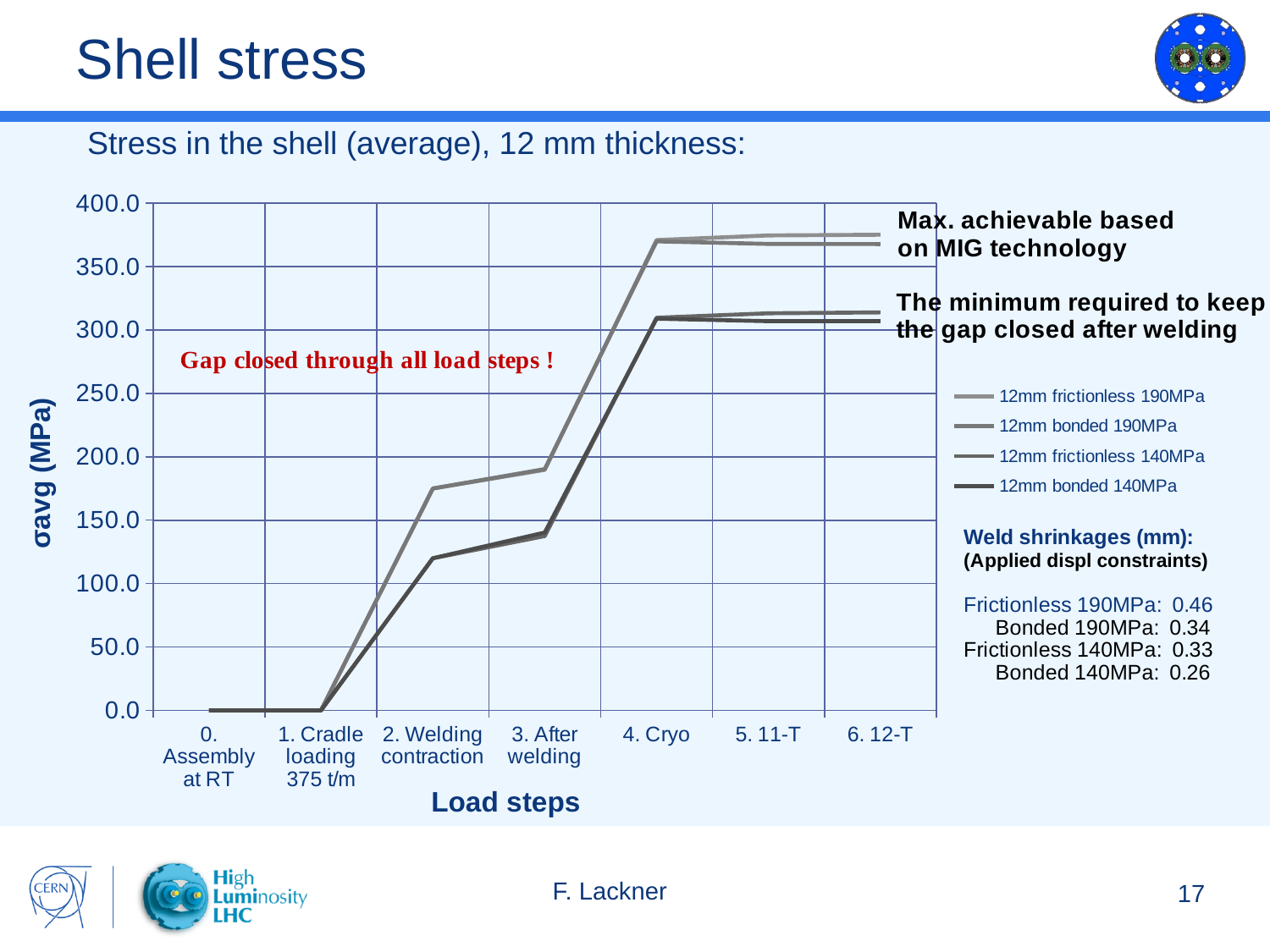
Is the value of the 12mm bonded 140MPa series at 4. Cryo greater or less than 350? less Is the value of the 12mm bonded 140MPa series at 2. Welding contraction greater or less than 150? less Do the values of the 12mm bonded 190MPa series rise or fall from 1. Cradle loading 375 t/m to 4. Cryo? rise How many load steps are shown on the x axis of the chart? 7 Is the value of the 12mm frictionless 190MPa series at 4. Cryo greater or less than 350? greater What is the value of the 12mm bonded 140MPa series at load step 0. Assembly at RT? 0.0 What is the value of the 12mm frictionless 190MPa series at load step 1. Cradle loading 375 t/m? 0.0 How many series does the chart legend list? 4 What kind of chart is shown on the slide? line chart What is the label of the y axis of the chart? σavg (MPa) At load step 4. Cryo, which series has the larger value: 12mm frictionless 190MPa or 12mm bonded 140MPa? 12mm frictionless 190MPa